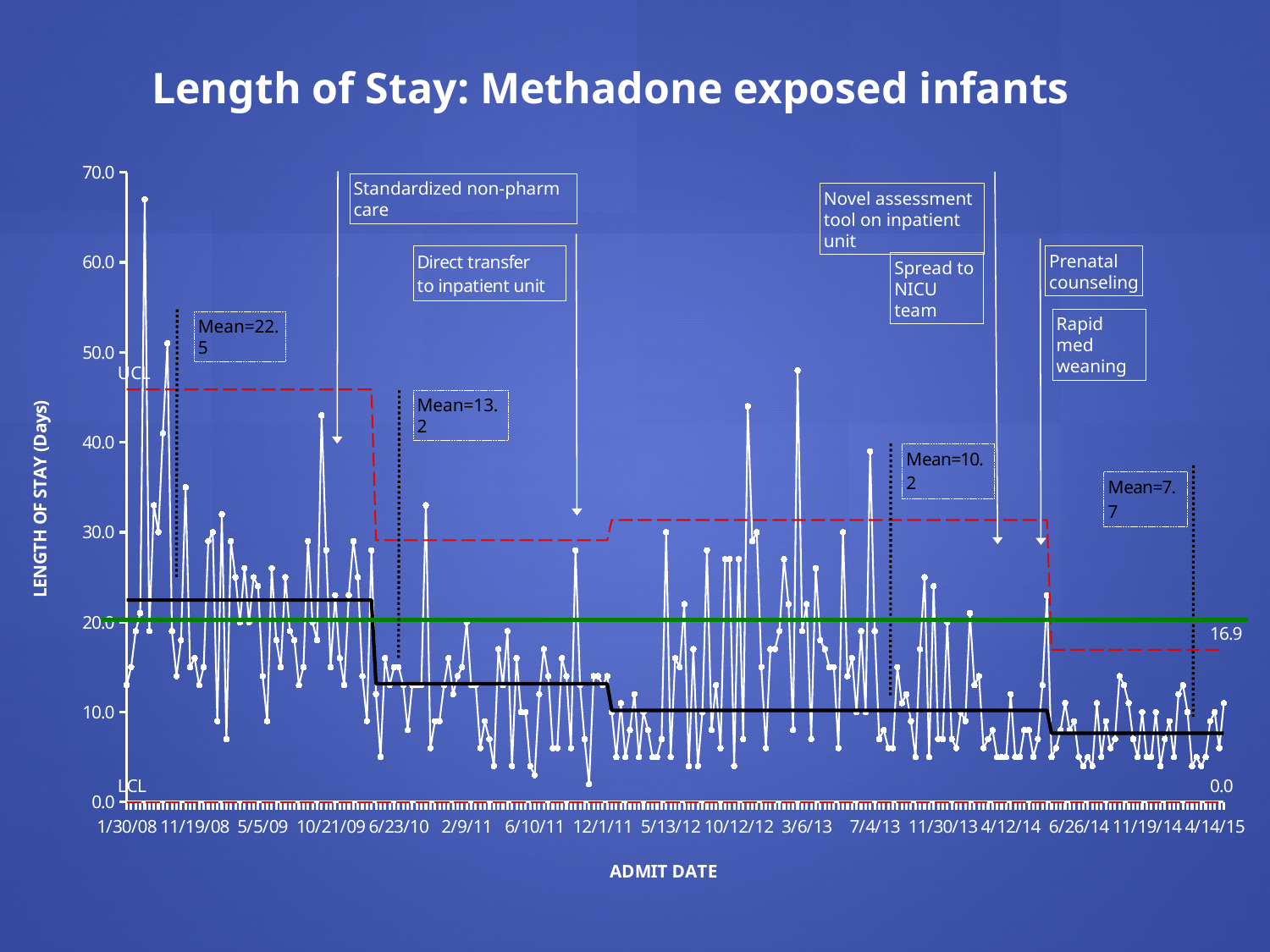
What is the value of the UCL at the right end of the chart? 16.9 Which annotated phase mean is the lowest? 7.7 What is the mean length of stay shown for the first phase of the chart? 22.5 What is the mean value annotated for the phase after 'Standardized non-pharm care' and 'Direct transfer to inpatient unit'? 13.2 What is the difference between the first phase mean (22.5) and the last phase mean (7.7)? 14.8 What is the title of the chart? Length of Stay: Methadone exposed infants What kind of chart is shown on the slide? line chart What is the mean length of stay shown for the last phase of the chart? 7.7 What is the label of the y axis? LENGTH OF STAY (Days) How many mean values are annotated on the chart? 4 What is the mean value annotated for the phase after 'Novel assessment tool on inpatient unit'? 10.2 Do the phase means rise or fall over time along the x axis? fall